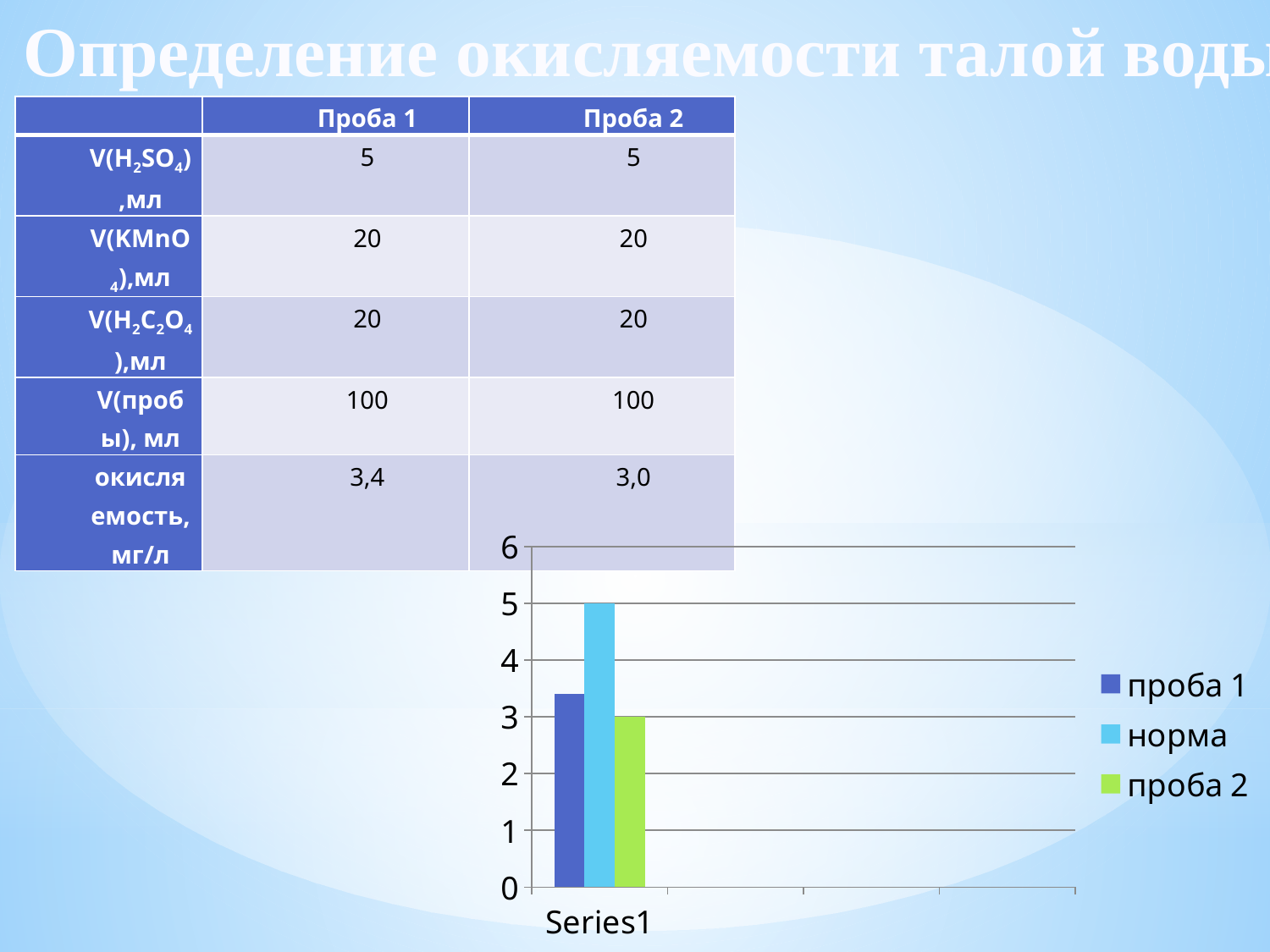
How many categories are shown on the x axis of the chart? 1 Which bar is taller in the chart, проба 1 or проба 2? проба 1 Is the value for проба 1 in the chart greater or less than 3? greater Is the value for проба 1 in the chart greater or less than 4? less What is the category label shown under the bars on the x axis? Series1 Which series has the lowest bar in the chart? проба 2 How many series does the chart legend list? 3 Which series has the highest bar in the chart? норма What is the difference between the норма bar and the проба 2 bar in the chart? 2 What is the value of the проба 2 bar in the chart? 3 What kind of chart is shown on the slide? bar chart What is the value of the норма bar in the chart? 5